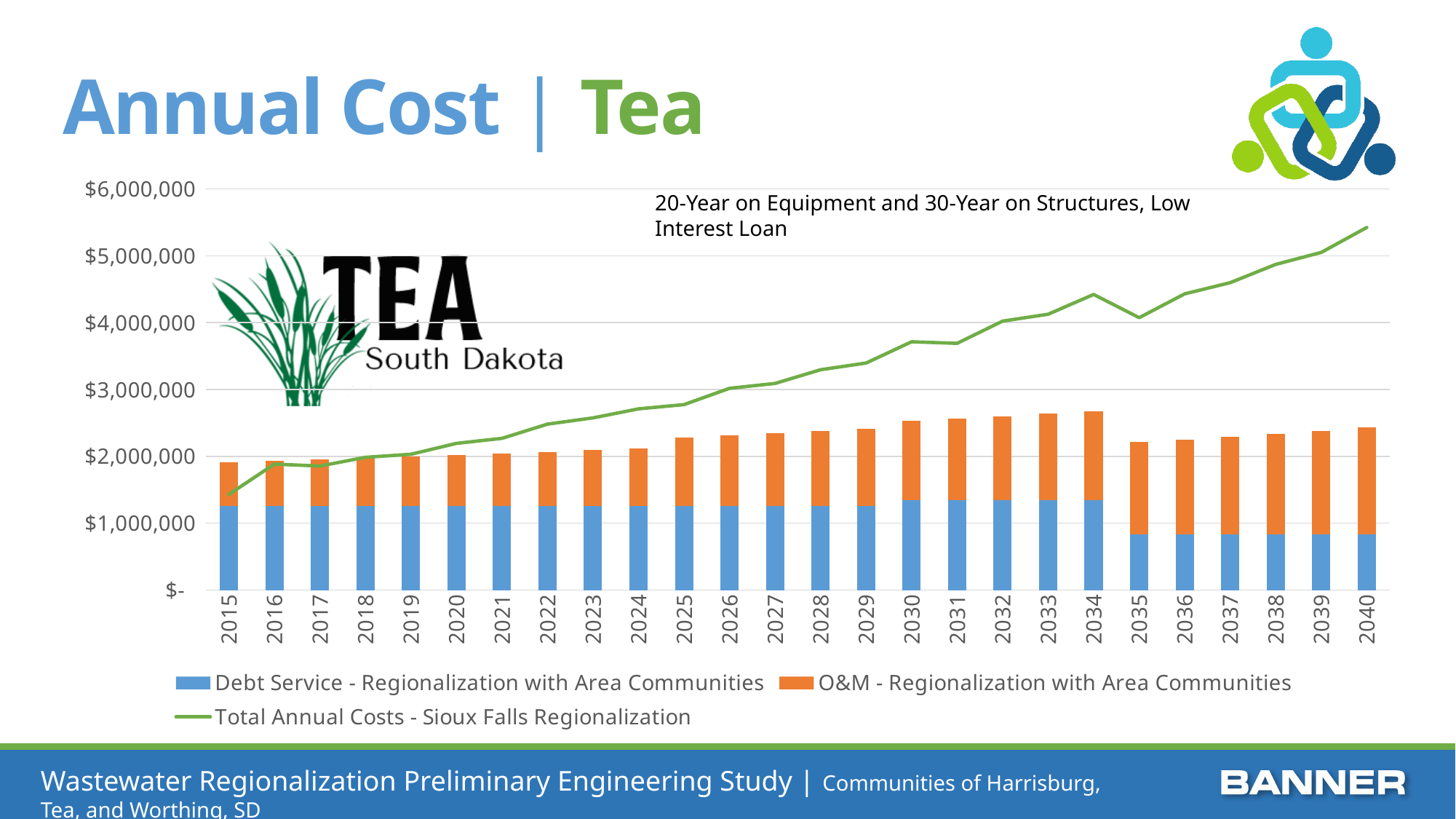
Is the Debt Service - Regionalization with Area Communities value for 2015 greater or less than $1,000,000? greater Does the Total Annual Costs - Sioux Falls Regionalization line generally rise or fall from 2015 to 2040? Rise What kind of chart is used to plot the Debt Service and O&M series? Stacked bar chart How many years are shown along the x axis of the chart? 26 In which year is the Total Annual Costs - Sioux Falls Regionalization value highest? 2040 How many series does the chart legend list? 3 Which is larger in 2040: the Total Annual Costs - Sioux Falls Regionalization line or the total of the stacked bar? Total Annual Costs - Sioux Falls Regionalization Is the Debt Service - Regionalization with Area Communities value for 2040 greater or less than $1,000,000? less Is the Total Annual Costs - Sioux Falls Regionalization value for 2015 greater or less than $2,000,000? less Which colour represents the O&M - Regionalization with Area Communities series? Orange What kind of chart is used to plot the Total Annual Costs - Sioux Falls Regionalization series? Line chart